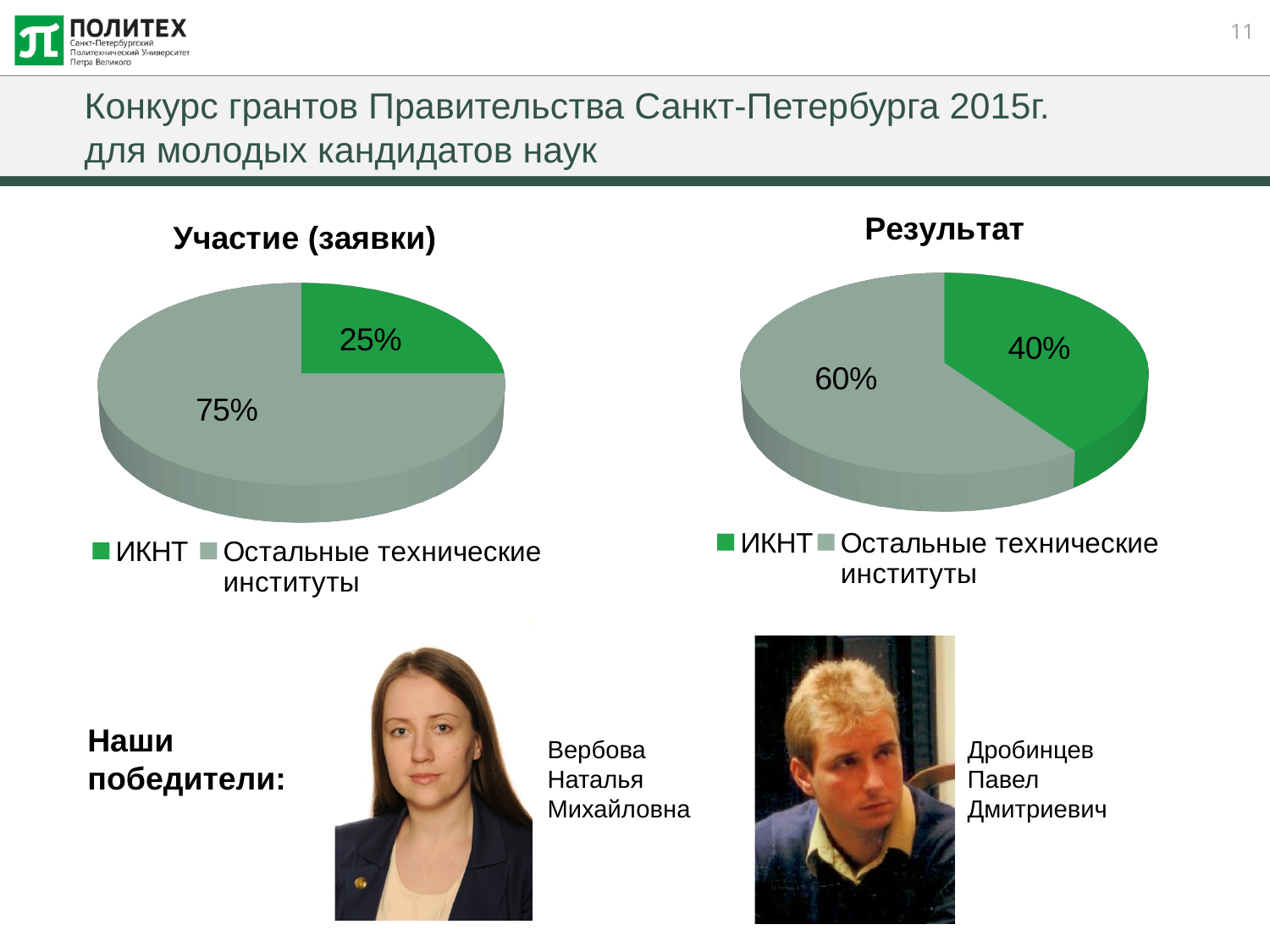
What type of chart is the "Результат" chart? Pie chart In the "Участие (заявки)" chart, what share do Остальные технические институты have? 75% In the "Результат" chart, what is the difference between the shares of Остальные технические институты and ИКНТ? 20% In the "Участие (заявки)" chart, what share does ИКНТ have? 25% In the "Участие (заявки)" chart, what is the difference between the shares of Остальные технические институты and ИКНТ? 50% In the "Результат" chart, what share does ИКНТ have? 40% In the "Участие (заявки)" chart, which slice is the largest? Остальные технические институты In the "Результат" chart, which slice is the smallest? ИКНТ In the "Результат" chart, what share do Остальные технические институты have? 60% How many slices does the "Участие (заявки)" chart have? 2 What colour is the ИКНТ slice in the "Результат" chart? Green Is the ИКНТ share larger in the "Участие (заявки)" chart or in the "Результат" chart? Результат